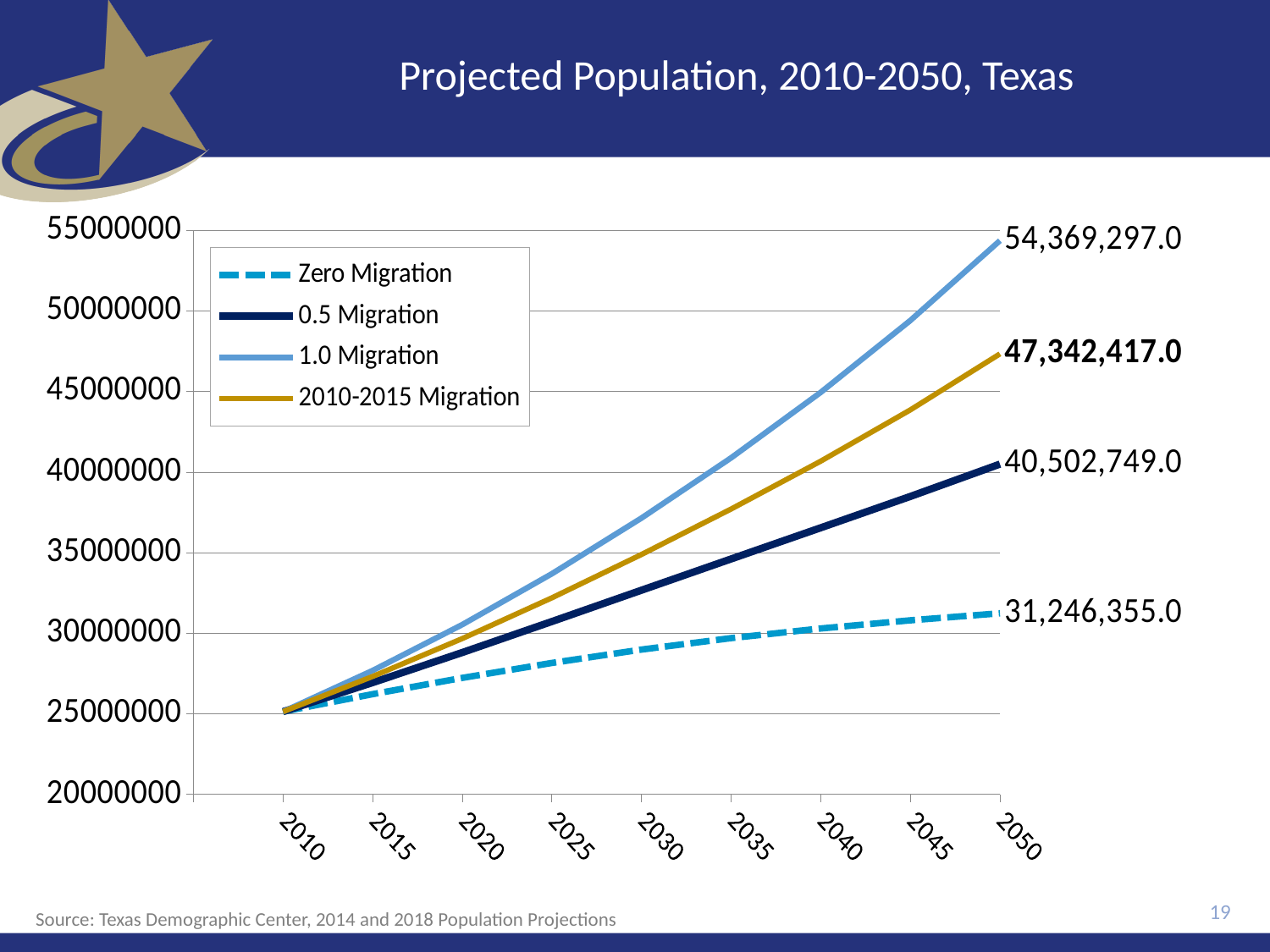
Which scenario has a larger 2050 projection: 0.5 Migration or 2010-2015 Migration? 2010-2015 Migration What is the projected population for Texas in 2050 under the 2010-2015 Migration scenario? 47,342,417.0 Do the projected population values rise or fall from 2010 to 2050 for all scenarios? rise What is the difference between the 2050 projections for the 1.0 Migration and Zero Migration scenarios? 23,122,942.0 What type of chart is shown on the slide? line chart What is the projected population for Texas in 2050 under the 1.0 Migration scenario? 54,369,297.0 What is the projected population for Texas in 2050 under the 0.5 Migration scenario? 40,502,749.0 How many series does the legend list? 4 Which migration scenario gives the highest projected population in 2050? 1.0 Migration Is the Zero Migration value for 2030 greater or less than 30000000? less What is the projected population for Texas in 2050 under the Zero Migration scenario? 31,246,355.0 Which migration scenario gives the lowest projected population in 2050? Zero Migration